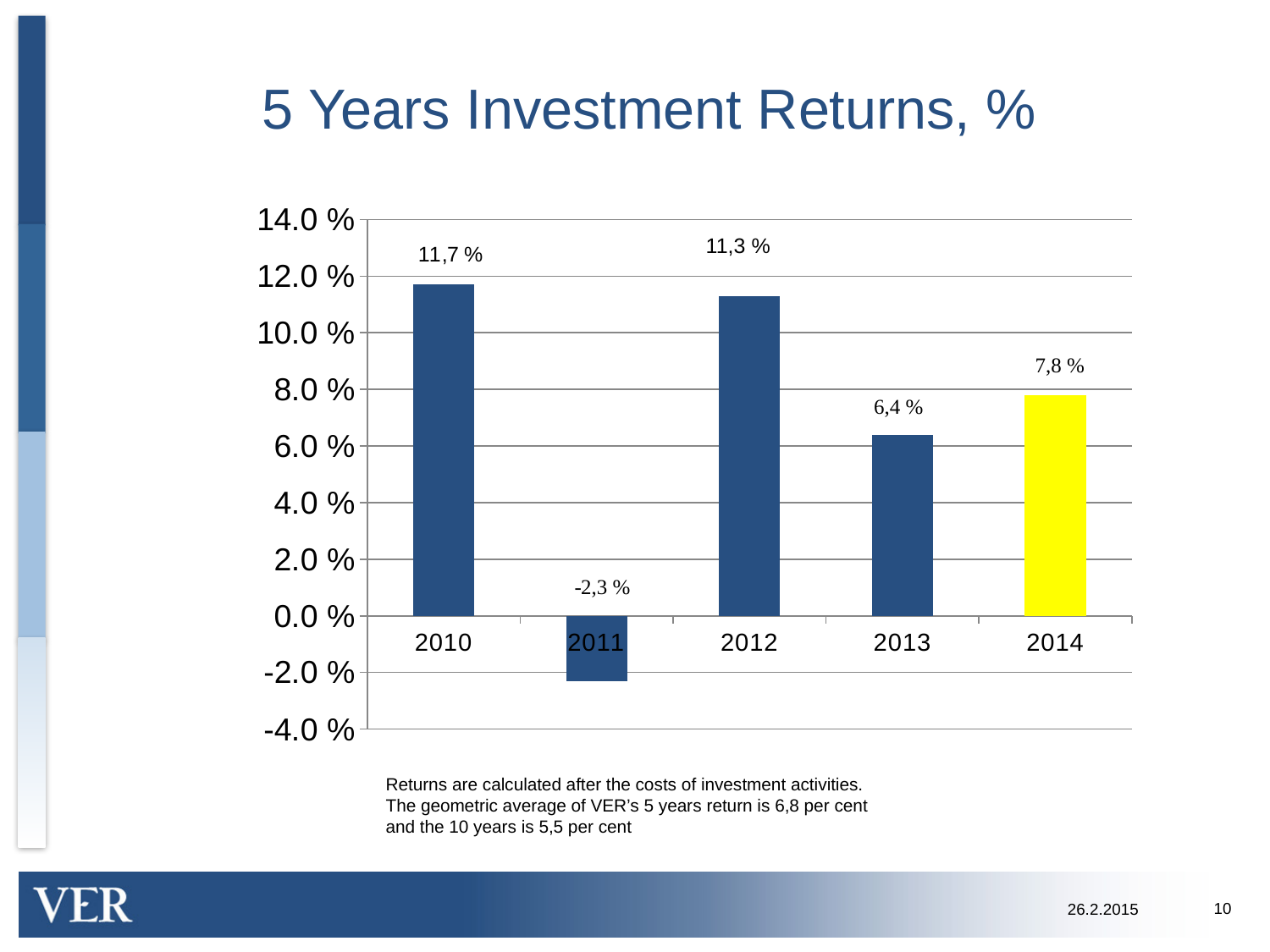
Which year has the lowest investment return? 2011 Which year's bar is coloured yellow? 2014 How many years are shown on the chart? 5 Is the value for 2012 greater or less than 10.0 %? greater What kind of chart is shown on the slide? Bar chart What is the difference between the returns for 2010 and 2012? 0,4 % What is the investment return for 2014? 7,8 % Which year has the larger return, 2013 or 2014? 2014 What is the difference between the returns for 2014 and 2013? 1,4 % Which year has the highest investment return? 2010 What is the investment return for 2011? -2,3 % What is the investment return for 2010? 11,7 %